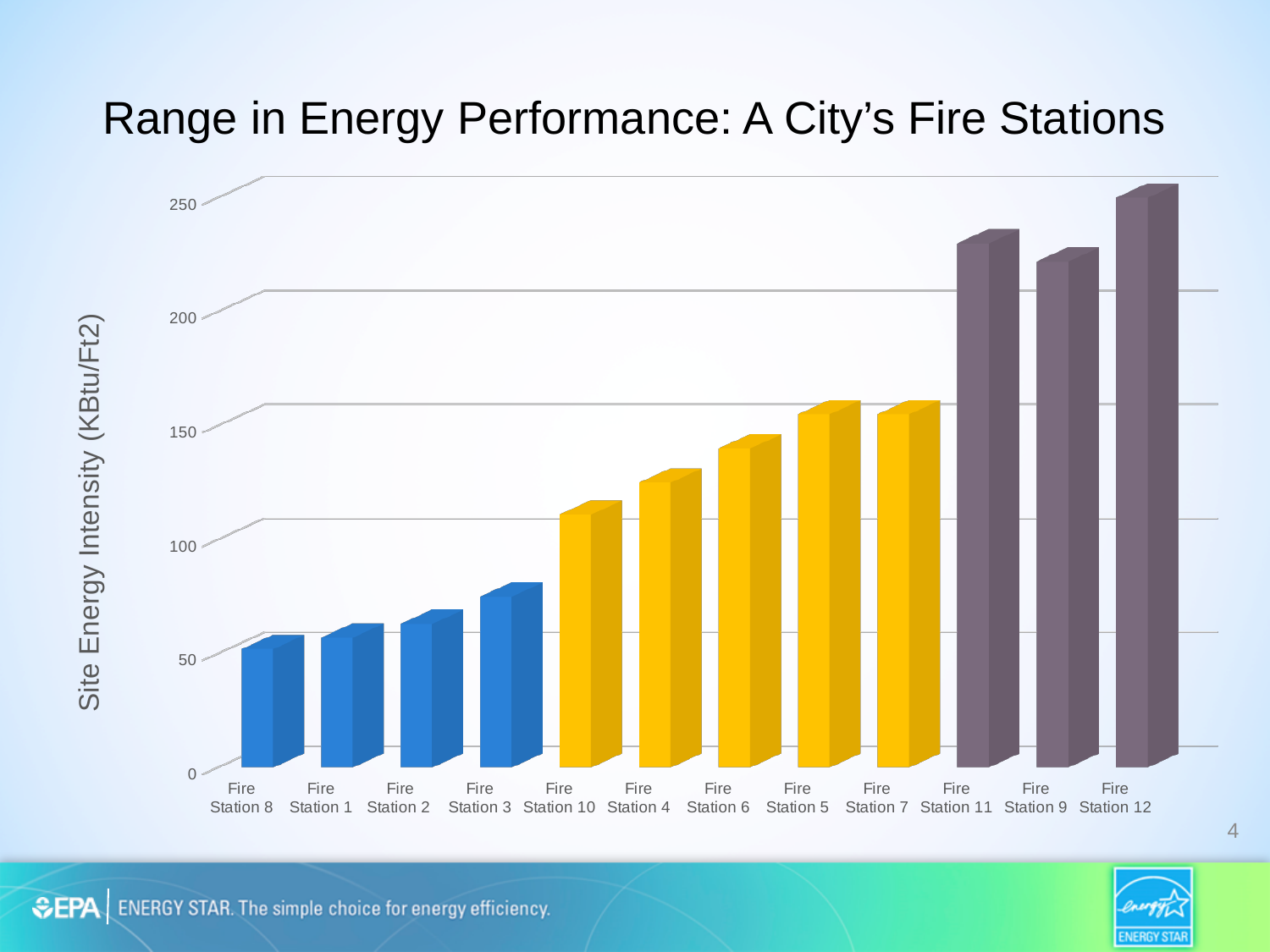
Is the value for Fire Station 6 greater or less than 150? less Do the bar values generally rise or fall from left to right across the chart? Rise Which fire station has the highest site energy intensity? Fire Station 12 What kind of chart is shown on the slide? Bar chart Is the value for Fire Station 11 greater or less than 200? greater What is the label on the vertical axis of the chart? Site Energy Intensity (KBtu/Ft2) Is the value for Fire Station 10 greater or less than 100? greater Which fire station has the lowest site energy intensity? Fire Station 8 Which has a higher site energy intensity, Fire Station 12 or Fire Station 11? Fire Station 12 How many fire stations are plotted on the chart? 12